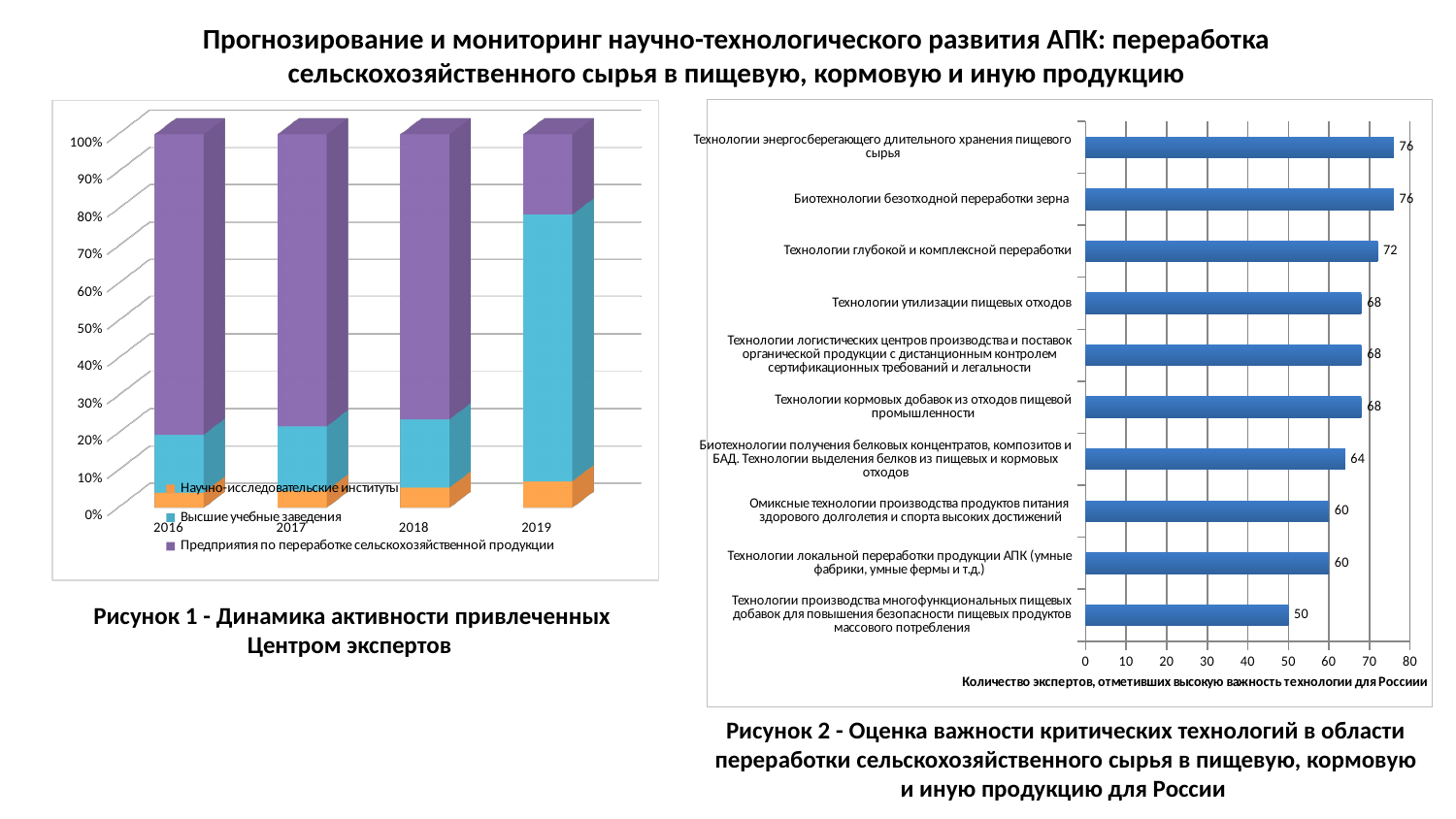
How many technologies (categories) are shown in the chart on the right (Рисунок 2)? 10 In the chart on the right (Рисунок 2), which has a larger value: 'Технологии глубокой и комплексной переработки' or 'Омиксные технологии производства продуктов питания здорового долголетия и спорта высоких достижений'? Технологии глубокой и комплексной переработки How many years are shown on the x axis of the chart on the left (Рисунок 1)? 4 In the chart on the right (Рисунок 2), what is the difference between the value for 'Технологии энергосберегающего длительного хранения пищевого сырья' and the value for 'Технологии производства многофункциональных пищевых добавок для повышения безопасности пищевых продуктов массового потребления'? 26 In the chart on the right (Рисунок 2), which technology has the lowest value? Технологии производства многофункциональных пищевых добавок для повышения безопасности пищевых продуктов массового потребления In the chart on the right (Рисунок 2), what value is shown for 'Биотехнологии безотходной переработки зерна'? 76 What is the x-axis title of the chart on the right (Рисунок 2)? Количество экспертов, отметивших высокую важность технологии для России In the chart on the right (Рисунок 2), what value is shown for 'Технологии утилизации пищевых отходов'? 68 What kind of chart is Рисунок 2 on the right of the slide? Bar chart How many series does the legend of the chart on the left (Рисунок 1) list? 3 In the chart on the right (Рисунок 2), what value is shown for 'Технологии глубокой и комплексной переработки'? 72 In the chart on the left (Рисунок 1), is the share for 'Предприятия по переработке сельскохозяйственной продукции' in 2016 greater or less than 50%? greater